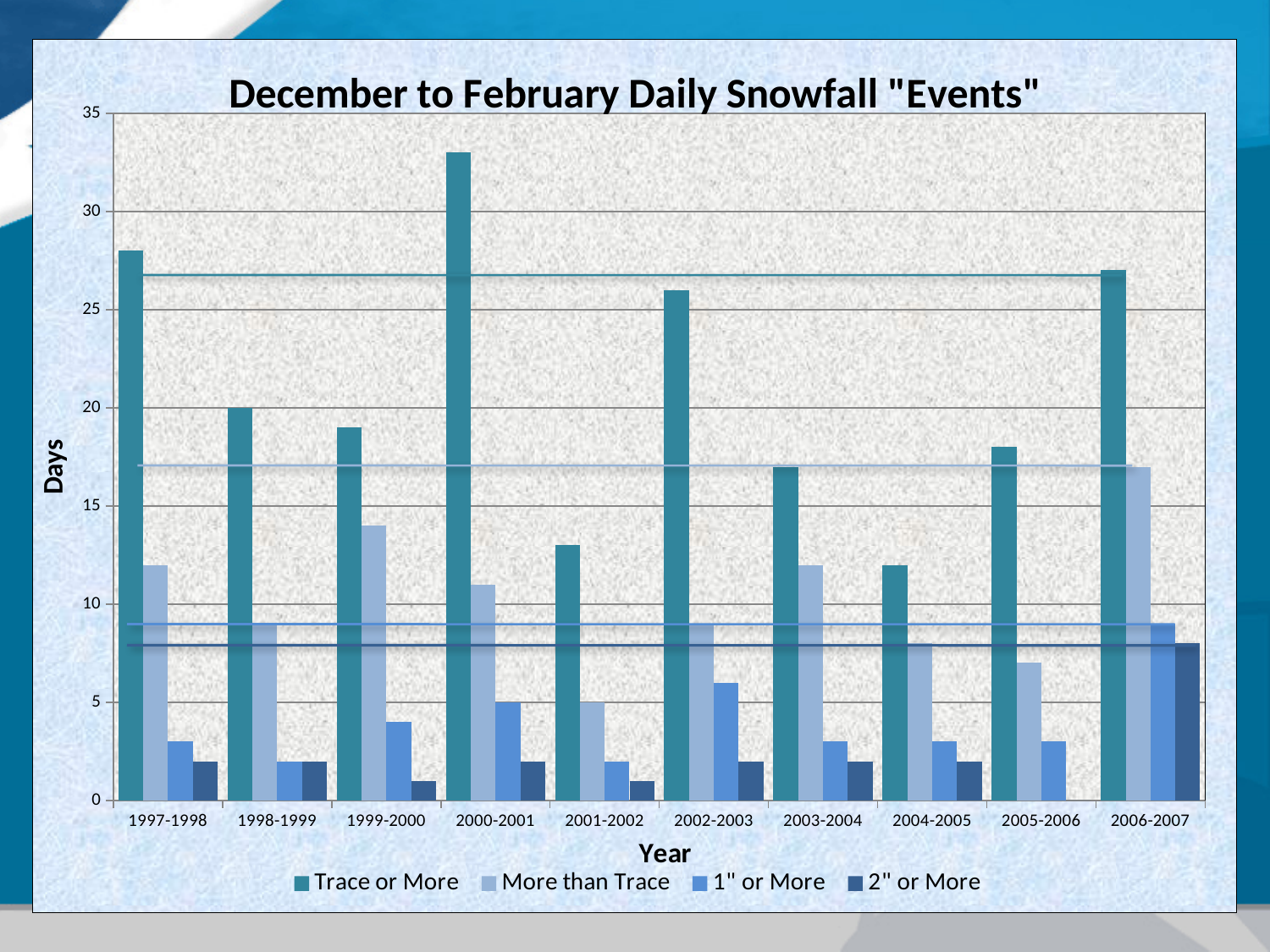
What is the 'More than Trace' value for 2001-2002? 5 Is the 'Trace or More' value for 2005-2006 greater or less than 20? less What is the 'Trace or More' value for 1998-1999? 20 How many series does the legend list? 4 How many years (categories) are shown on the x axis? 10 In which year is the 'More than Trace' value highest? 2006-2007 In which year is the 'Trace or More' value highest? 2000-2001 Is the 'Trace or More' value for 2000-2001 greater or less than 30? greater Which year has the larger 'Trace or More' value, 1997-1998 or 1998-1999? 1997-1998 In which year is the '2" or More' value highest? 2006-2007 What kind of chart is shown on the slide? bar chart What is the title of the chart? December to February Daily Snowfall "Events"